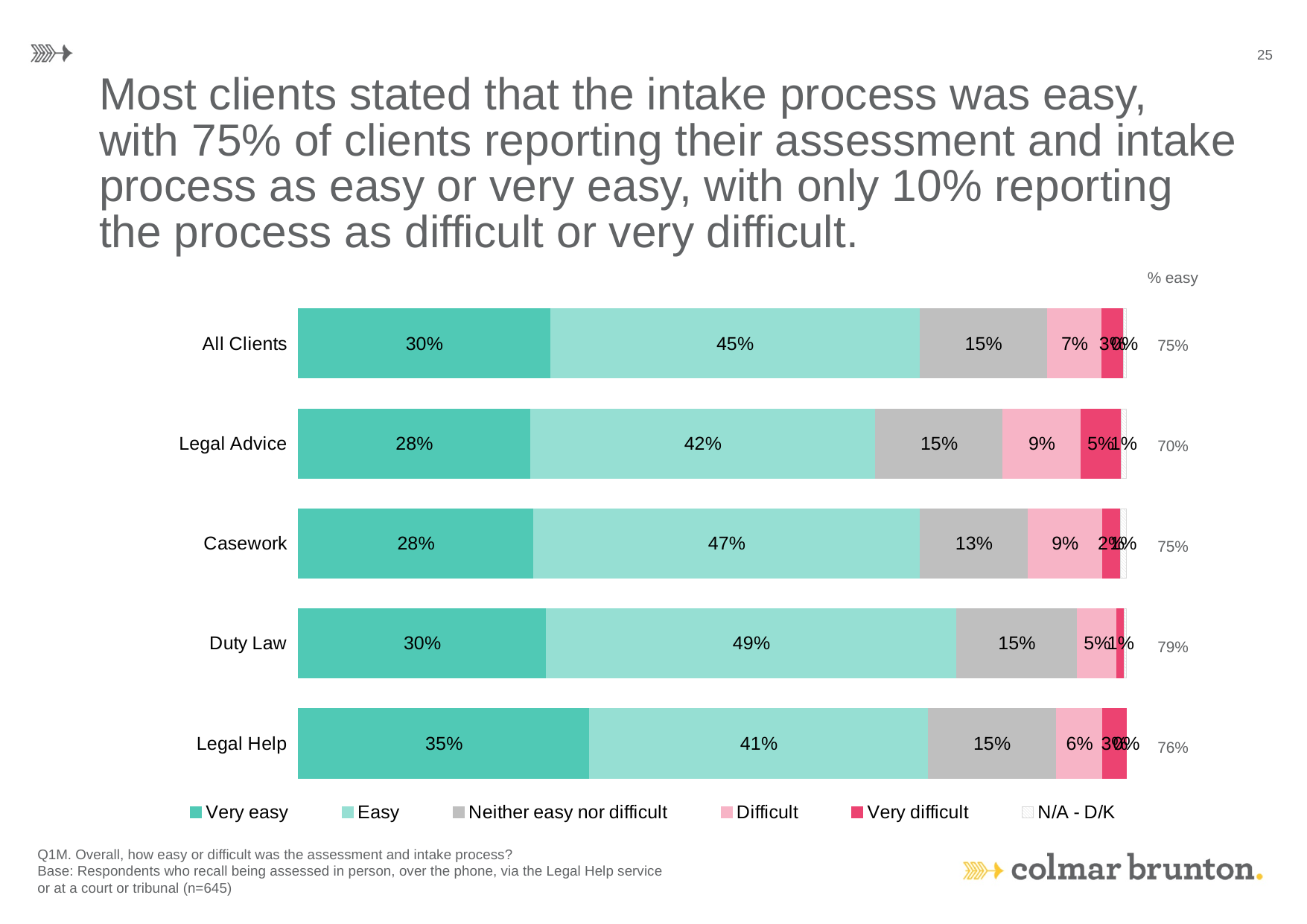
What is the Difficult value for Legal Advice? 9% What is the Neither easy nor difficult value for Casework? 13% Which has a larger Very easy value, All Clients or Legal Advice? All Clients What percentage of Duty Law clients rated the intake process as Easy? 49% Which category has the lowest % easy figure? Legal Advice How many series does the legend list? 6 Which category has the highest Very easy value? Legal Help How many categories are shown on the chart? 5 Which category has the highest Easy value? Duty Law What is the difference between the Easy values for Duty Law and Legal Help? 8 percentage points What is the % easy figure shown for Duty Law? 79% What percentage of Legal Help clients rated the intake process as Very easy? 35%